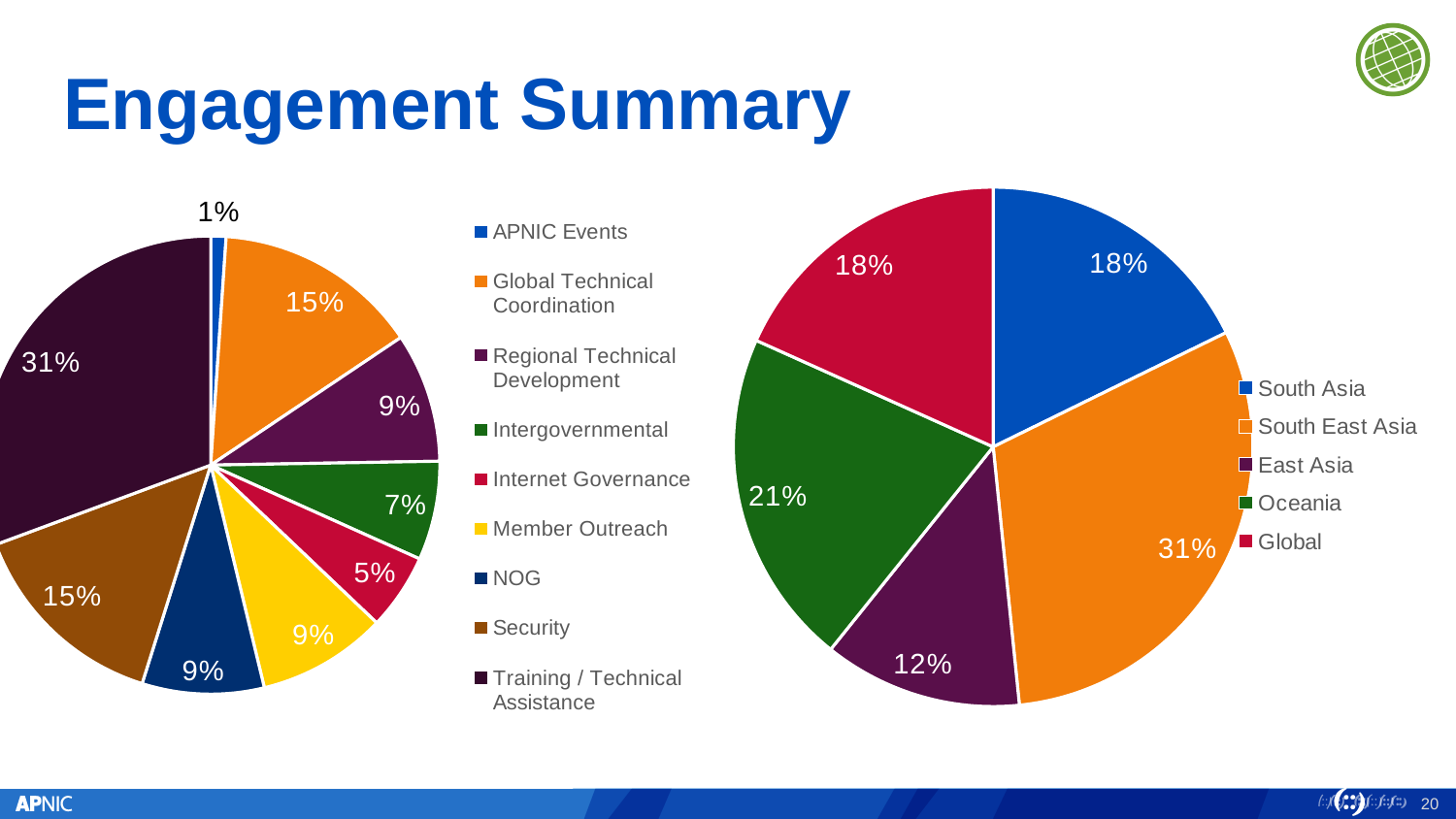
On the left pie chart, what share does Global Technical Coordination have? 15% On the right pie chart, what share does South East Asia have? 31% On the left pie chart, which category has the largest share? Training / Technical Assistance On the right pie chart, how many regions are shown? 5 On the right pie chart, which region has the smallest share? East Asia On the left pie chart, what share does Training / Technical Assistance have? 31% On the left pie chart, how many categories does the legend list? 9 What type of chart is shown on the right side of the slide? Pie chart On the left pie chart, what is the difference between the Security share and the Internet Governance share? 10% On the left pie chart, which category has the smallest share? APNIC Events On the right pie chart, which is larger, the share for Oceania or the share for East Asia? Oceania